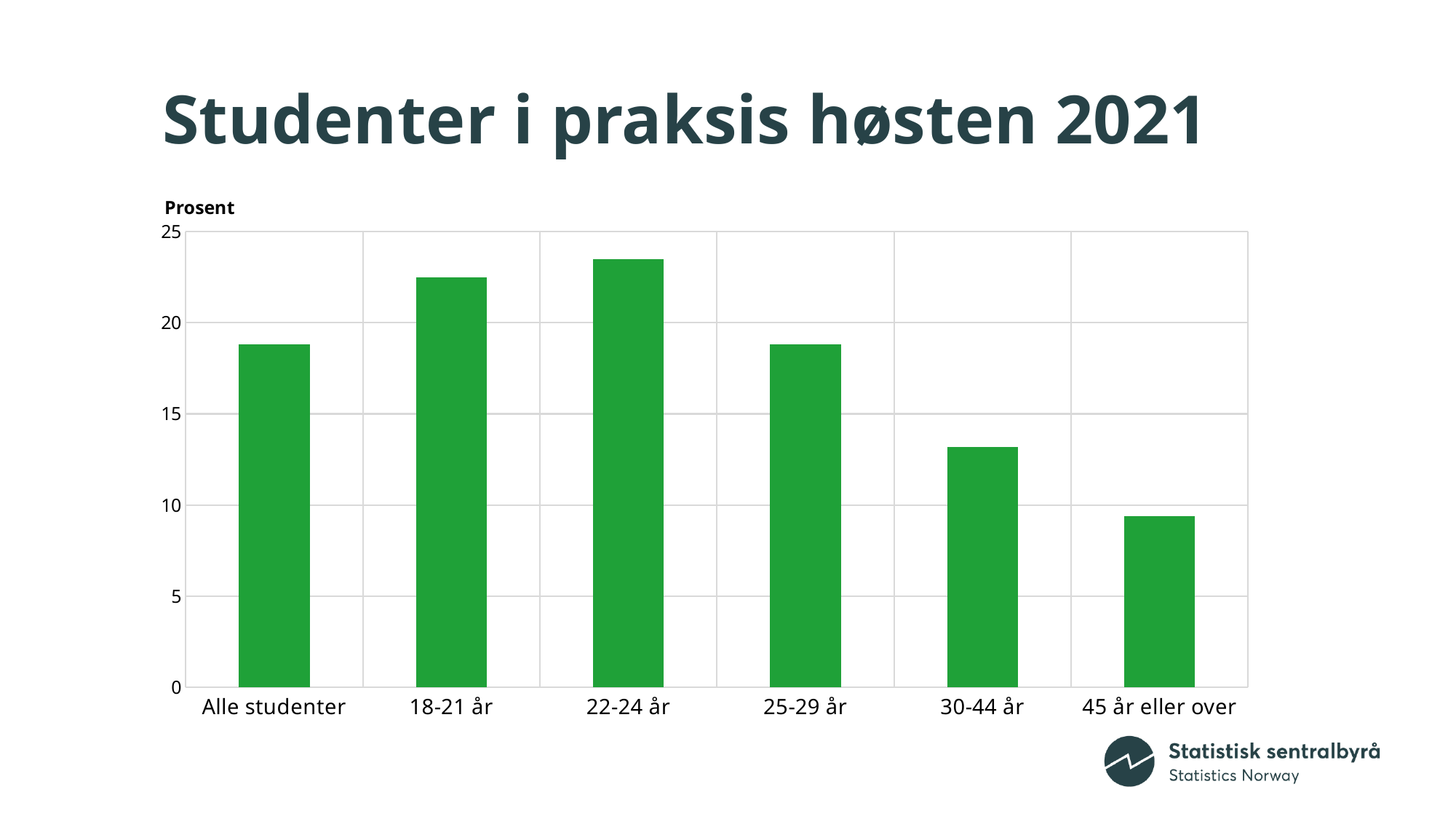
Which is larger, the value for 18-21 år or the value for 30-44 år? 18-21 år What is the label on the vertical axis of the chart? Prosent Which category has the highest value in the chart? 22-24 år What kind of chart is shown on the slide? bar chart Is the value for 30-44 år greater or less than 15? less Is the value for Alle studenter greater or less than 20? less Which category has the lowest value in the chart? 45 år eller over Is the value for 22-24 år greater or less than 20? greater How many categories are shown on the x axis of the chart? 6 What is the title of the chart on the slide? Studenter i praksis høsten 2021 Do the values rise or fall from 22-24 år to 45 år eller over? fall